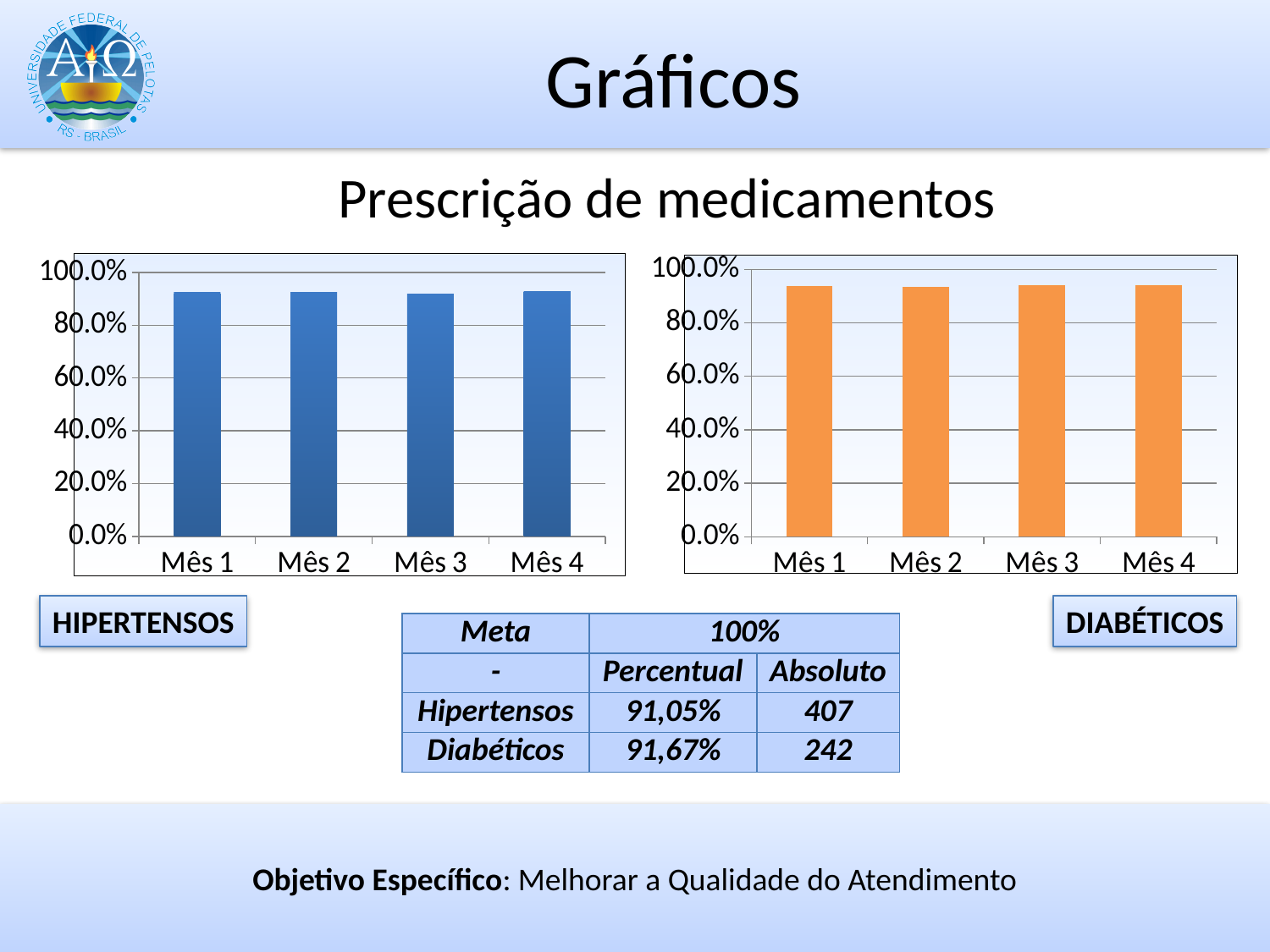
How many categories are shown on the x axis of the left chart (HIPERTENSOS)? 4 How many bars are plotted in the right chart (DIABÉTICOS)? 4 What kind of chart is the right chart (DIABÉTICOS)? bar chart In the right chart (DIABÉTICOS), is the value for Mês 4 greater or less than 100.0%? less In the left chart (HIPERTENSOS), is the value for Mês 3 greater or less than 100.0%? less What colour are the bars in the right chart (DIABÉTICOS)? orange What is the highest tick value shown on the y axis of the left chart (HIPERTENSOS)? 100.0% In the right chart (DIABÉTICOS), is the value for Mês 2 greater or less than 80.0%? greater What is the label of the first category on the x axis of the right chart (DIABÉTICOS)? Mês 1 What kind of chart is the left chart (HIPERTENSOS)? bar chart What is the lowest tick value shown on the y axis of the right chart (DIABÉTICOS)? 0.0%